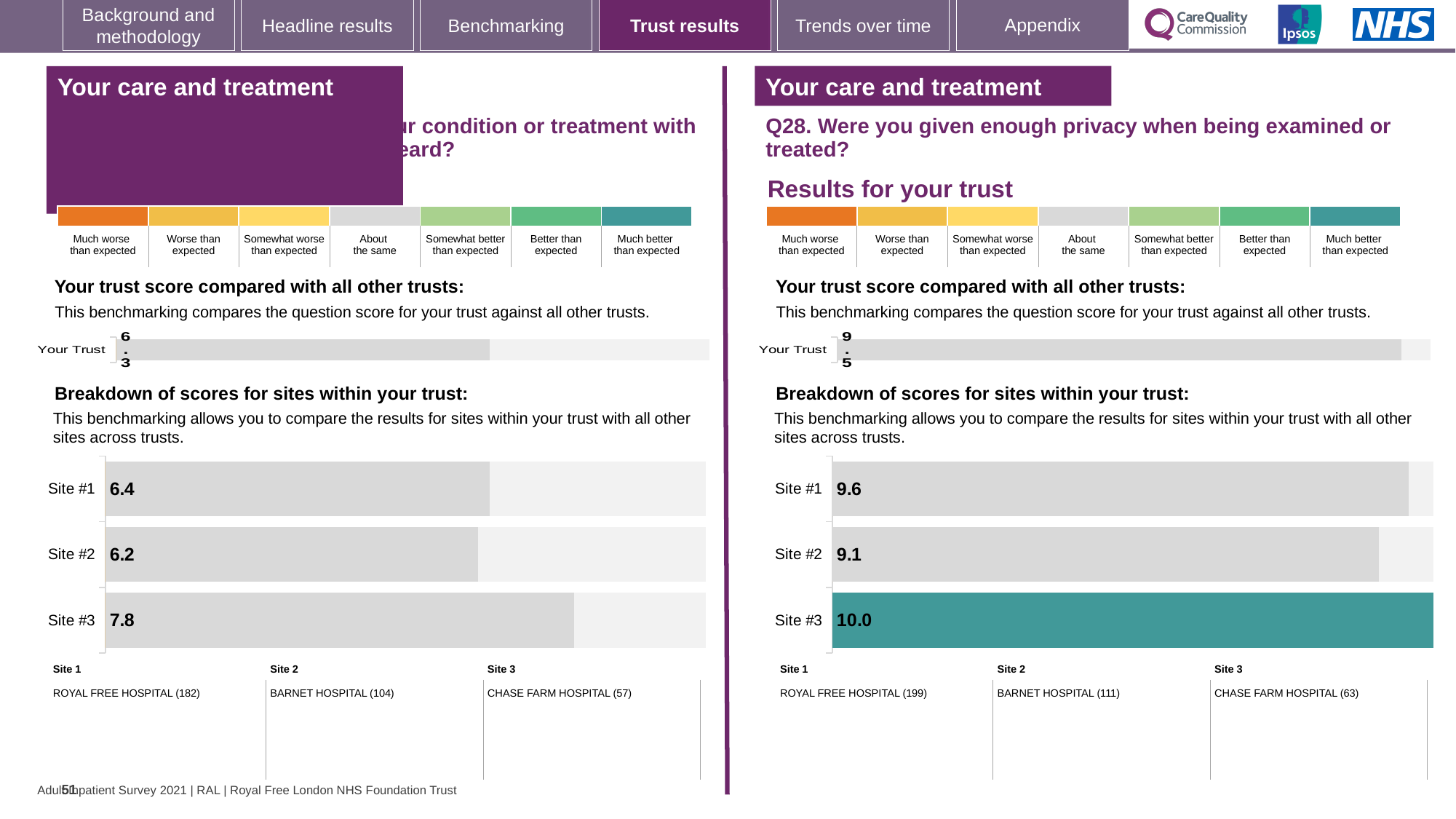
How many sites are shown in the right-hand site breakdown chart (Q28)? 3 In the left-hand site breakdown chart, which site has the highest score? Site #3 In the right-hand chart (Q28), what is the score for Site #2? 9.1 In the right-hand chart (Q28), which site has the lowest score? Site #2 In the right-hand chart (Q28, privacy when being examined or treated), what is the score for Site #3? 10.0 What kind of chart is used for the site breakdown on the right-hand side (Q28)? Bar chart In the left-hand site breakdown chart, what is the score for Site #1? 6.4 In the left-hand site breakdown chart, what is the difference between the scores for Site #3 and Site #2? 1.6 In the right-hand chart (Q28), which site has the highest score? Site #3 In the left-hand site breakdown chart, what is the score for Site #3? 7.8 In the right-hand chart (Q28), what is the difference between the scores for Site #3 and Site #2? 0.9 In the right-hand chart (Q28), what is the score for Site #1? 9.6